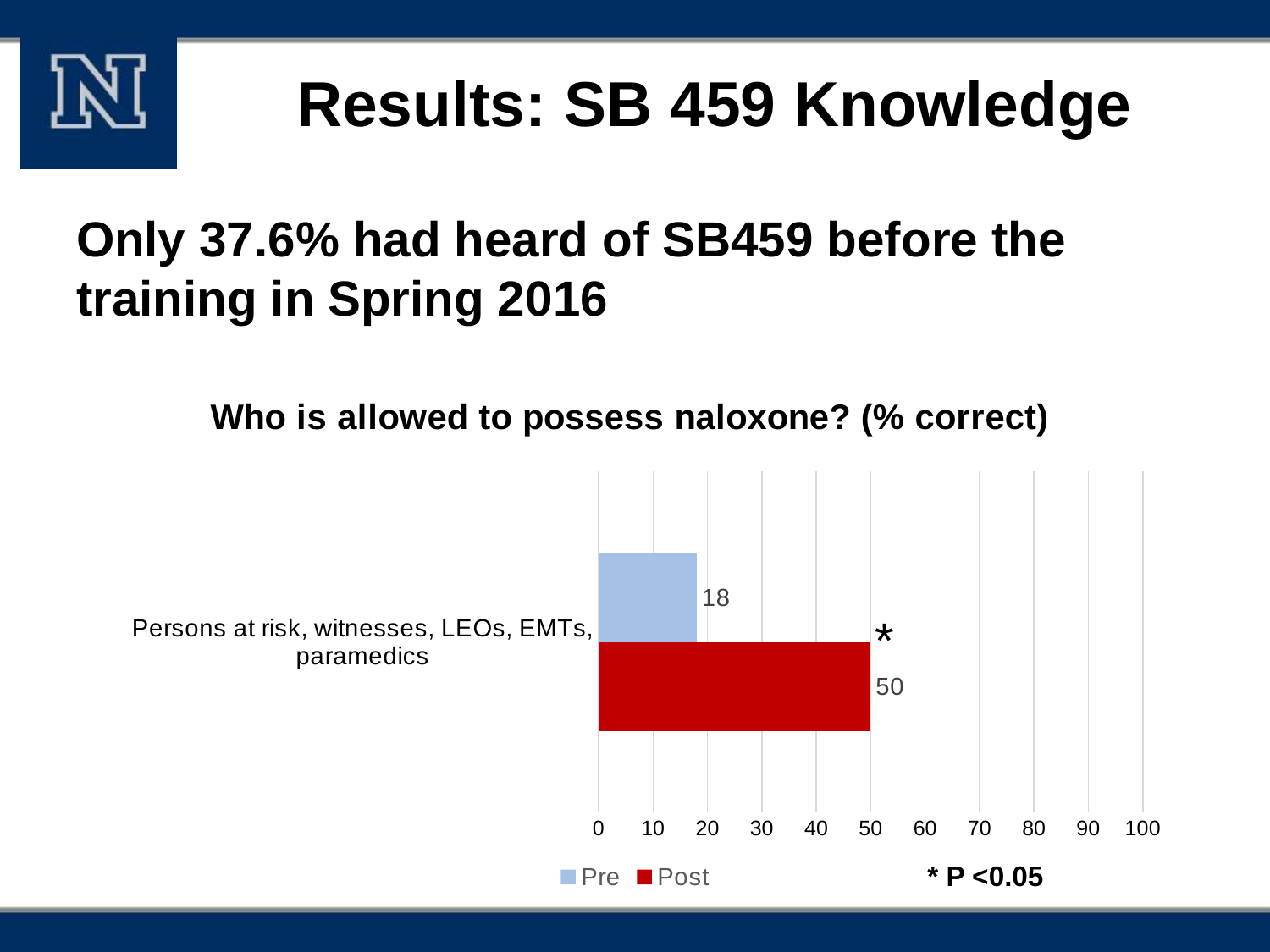
Which series is shown in red? Post What kind of chart is shown? bar chart Which series has the higher value, Pre or Post? Post How many series does the legend list? 2 How many categories are shown on the chart? 1 What is the title of the chart? Who is allowed to possess naloxone? (% correct) What is the difference between the Post and Pre values? 32 What is the Post value for 'Persons at risk, witnesses, LEOs, EMTs, paramedics'? 50 What is the maximum value shown on the x axis? 100 What is the Pre value for 'Persons at risk, witnesses, LEOs, EMTs, paramedics'? 18 Is the Pre value greater or less than 20? less Is the Post value greater or less than 40? greater